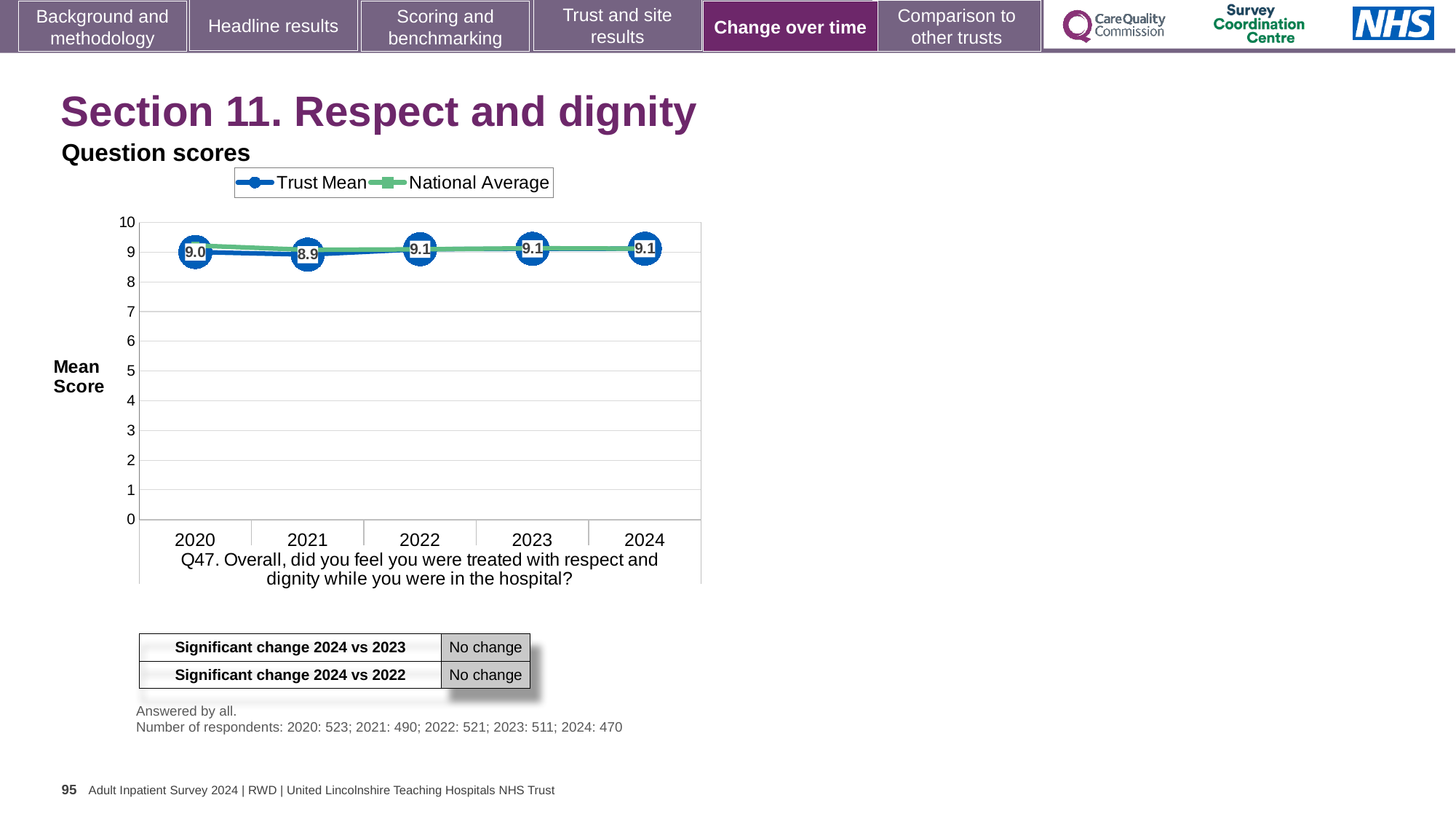
Is the National Average value for 2020 greater or less than 8? greater What is the Trust Mean score for 2020? 9.0 What kind of chart is shown on the slide? line chart How many years are shown on the x axis of the chart? 5 In which year is the Trust Mean score lowest? 2021 Does the Trust Mean score rise or fall from 2021 to 2022? rise Which year has the larger Trust Mean score, 2021 or 2023? 2023 How many series does the chart legend list? 2 What is the Trust Mean score for 2021? 8.9 What is the difference between the Trust Mean scores for 2022 and 2021? 0.2 What are the two series named in the chart legend? Trust Mean and National Average What is the Trust Mean score for 2024? 9.1